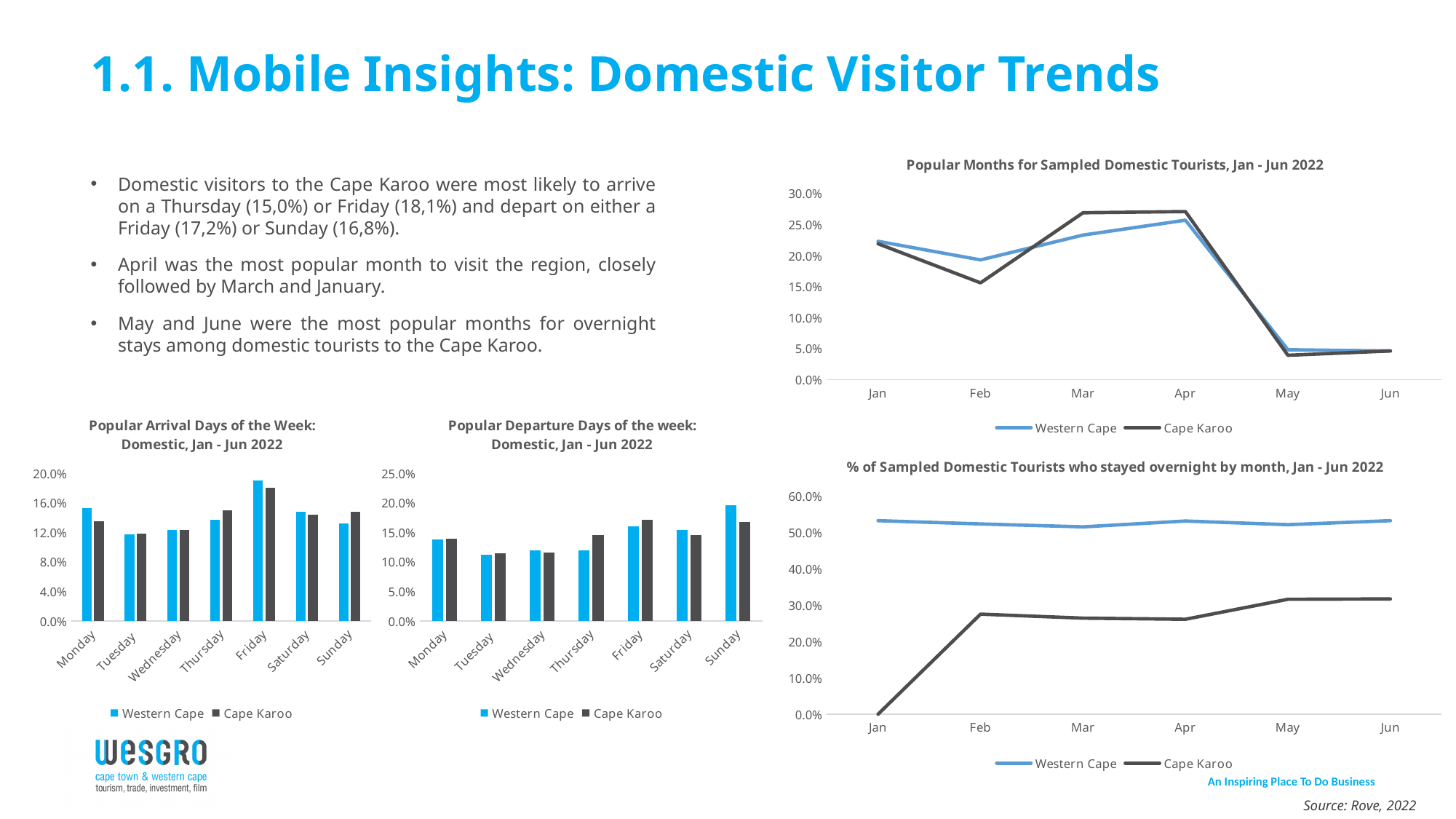
In the '% of Sampled Domestic Tourists who stayed overnight by month' chart, which series has the larger value in Jun, Western Cape or Cape Karoo? Western Cape In the 'Popular Months for Sampled Domestic Tourists' chart, do the values rise or fall from Apr to May? Fall In the '% of Sampled Domestic Tourists who stayed overnight by month' chart, is the Western Cape value for Jan greater or less than 50.0%? greater How many months are shown on the x axis of the 'Popular Months for Sampled Domestic Tourists' chart? 6 What kind of chart is the 'Popular Months for Sampled Domestic Tourists, Jan - Jun 2022' chart? Line chart In the 'Popular Months for Sampled Domestic Tourists' chart, which month has the highest Western Cape value? Apr In the 'Popular Months for Sampled Domestic Tourists' chart, is the Cape Karoo value for Feb greater or less than 20.0%? less In the 'Popular Departure Days of the week' chart, which day has the highest Western Cape value? Sunday What kind of chart is the 'Popular Arrival Days of the Week: Domestic, Jan - Jun 2022' chart? Bar chart How many series does the legend of the 'Popular Departure Days of the week' chart list? 2 In the 'Popular Arrival Days of the Week' chart, which day has the highest Western Cape value? Friday How many day categories are shown on the x axis of the 'Popular Arrival Days of the Week' chart? 7